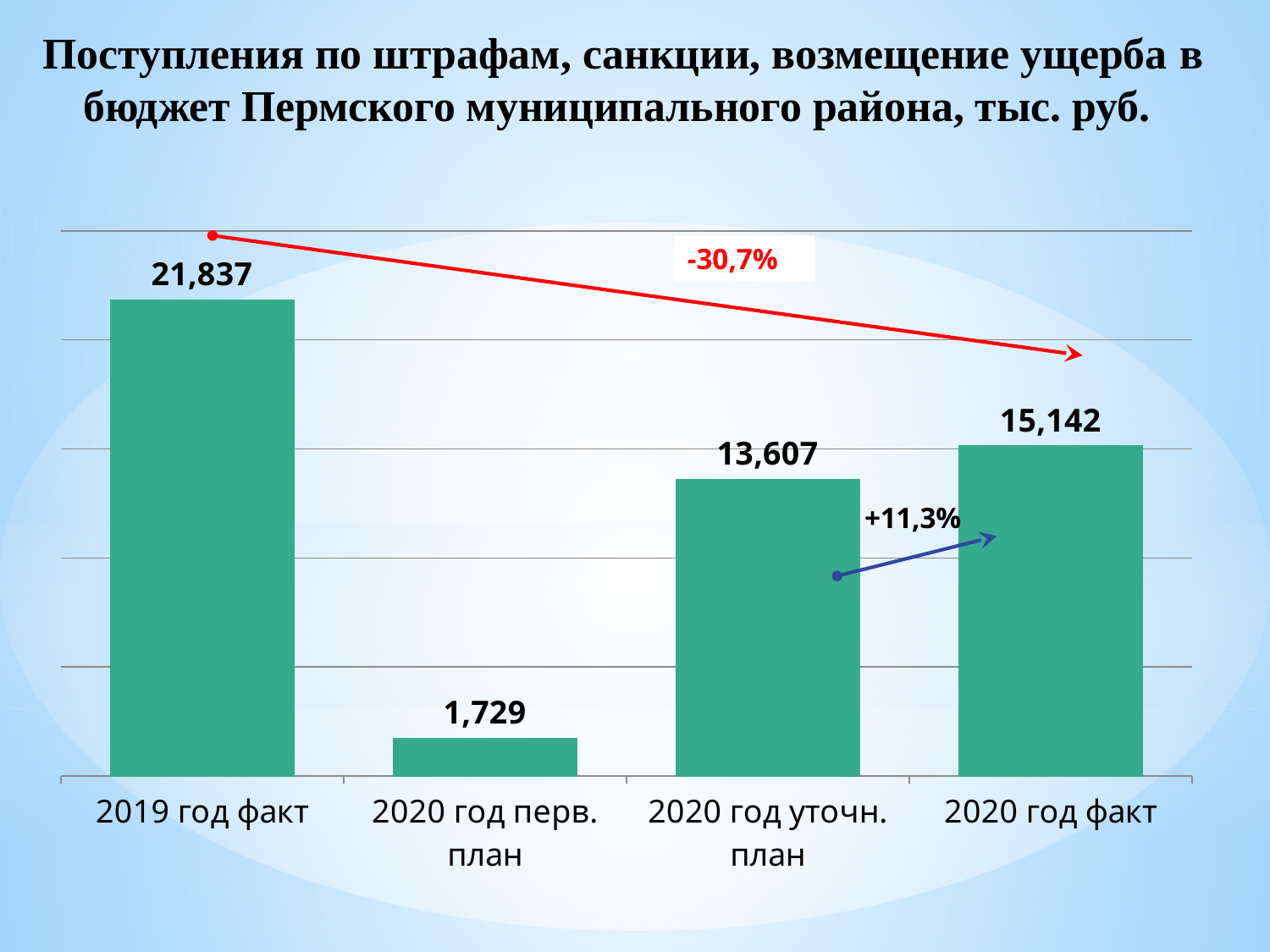
What kind of chart is shown on the slide? Bar chart What percentage change is shown by the red arrow from 2019 год факт to 2020 год факт? -30,7% What is the difference between the values for 2019 год факт and 2020 год факт? 6,695 What is the value for 2020 год факт? 15,142 Which category has the lowest value? 2020 год перв. план What is the difference between the values for 2020 год факт and 2020 год уточн. план? 1,535 What is the value for 2019 год факт? 21,837 What is the value for 2020 год перв. план? 1,729 Which category has the highest value? 2019 год факт Which is larger, the value for 2020 год уточн. план or the value for 2020 год факт? 2020 год факт What is the value for 2020 год уточн. план? 13,607 How many categories are shown on the chart? 4